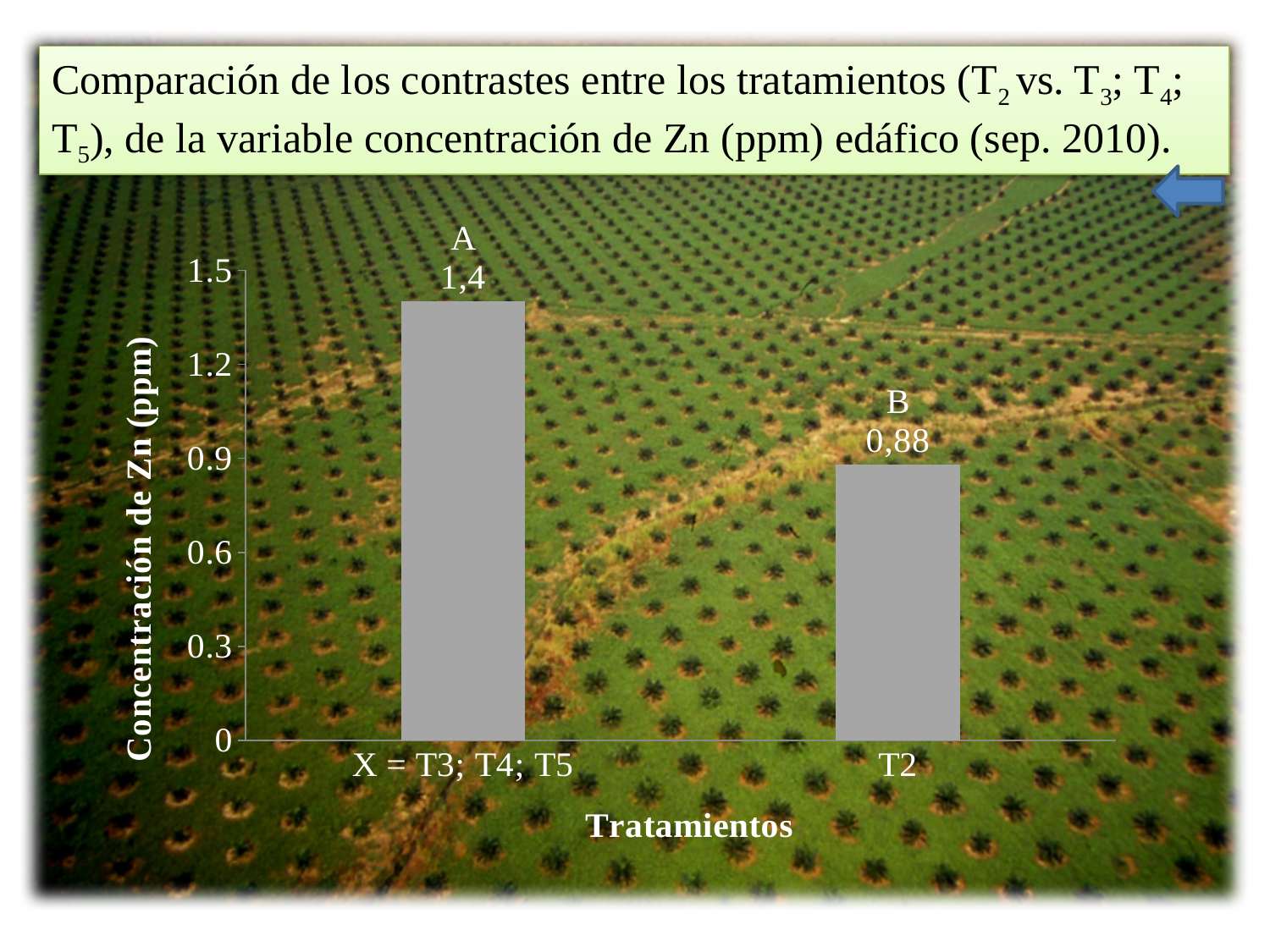
What is the difference between the Zn concentration for X = T3; T4; T5 and for T2? 0,52 Is the value for T2 greater or less than 0.9? less What is the Zn concentration value shown for T2? 0,88 What statistical group letter is shown above the T2 bar? B How many categories are shown on the x axis? 2 Which category has the highest Zn concentration? X = T3; T4; T5 What is the Zn concentration value shown for the category X = T3; T4; T5? 1,4 What kind of chart is shown on the slide? bar chart Is the value for X = T3; T4; T5 greater or less than 1.2? greater What is the label of the y axis? Concentración de Zn (ppm) Which category has the lowest Zn concentration? T2 Which has a larger Zn concentration, X = T3; T4; T5 or T2? X = T3; T4; T5